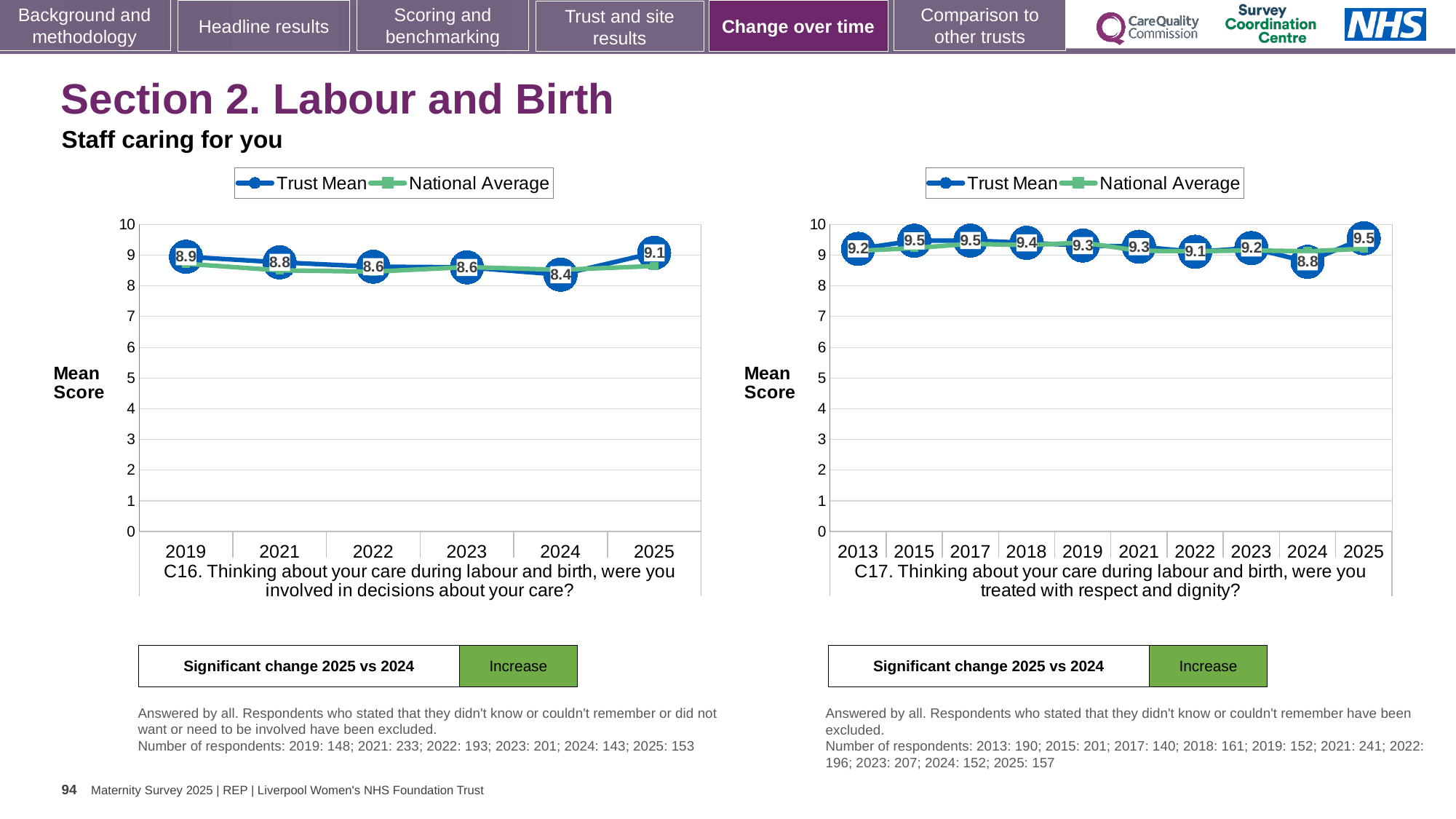
In the C16 chart on the left, which year has the lowest Trust Mean score? 2024 In the C16 chart on the left, what is the Trust Mean score for 2025? 9.1 In the C17 chart on the right, what is the Trust Mean score for 2013? 9.2 How many series does the legend of the C17 chart on the right list? 2 In the C16 chart on the left, which year has the highest Trust Mean score? 2025 How many years are plotted on the x axis of the C16 chart on the left? 6 In the C17 chart on the right, is the Trust Mean score for 2018 or 2022 larger? 2018 In the C16 chart on the left, what is the Trust Mean score for 2019? 8.9 In the C16 chart on the left, what is the difference between the Trust Mean scores for 2025 and 2024? 0.7 In the C17 chart on the right, which year has the lowest Trust Mean score? 2024 How many years are plotted on the x axis of the C17 chart on the right? 10 In the C17 chart on the right, what is the Trust Mean score for 2024? 8.8